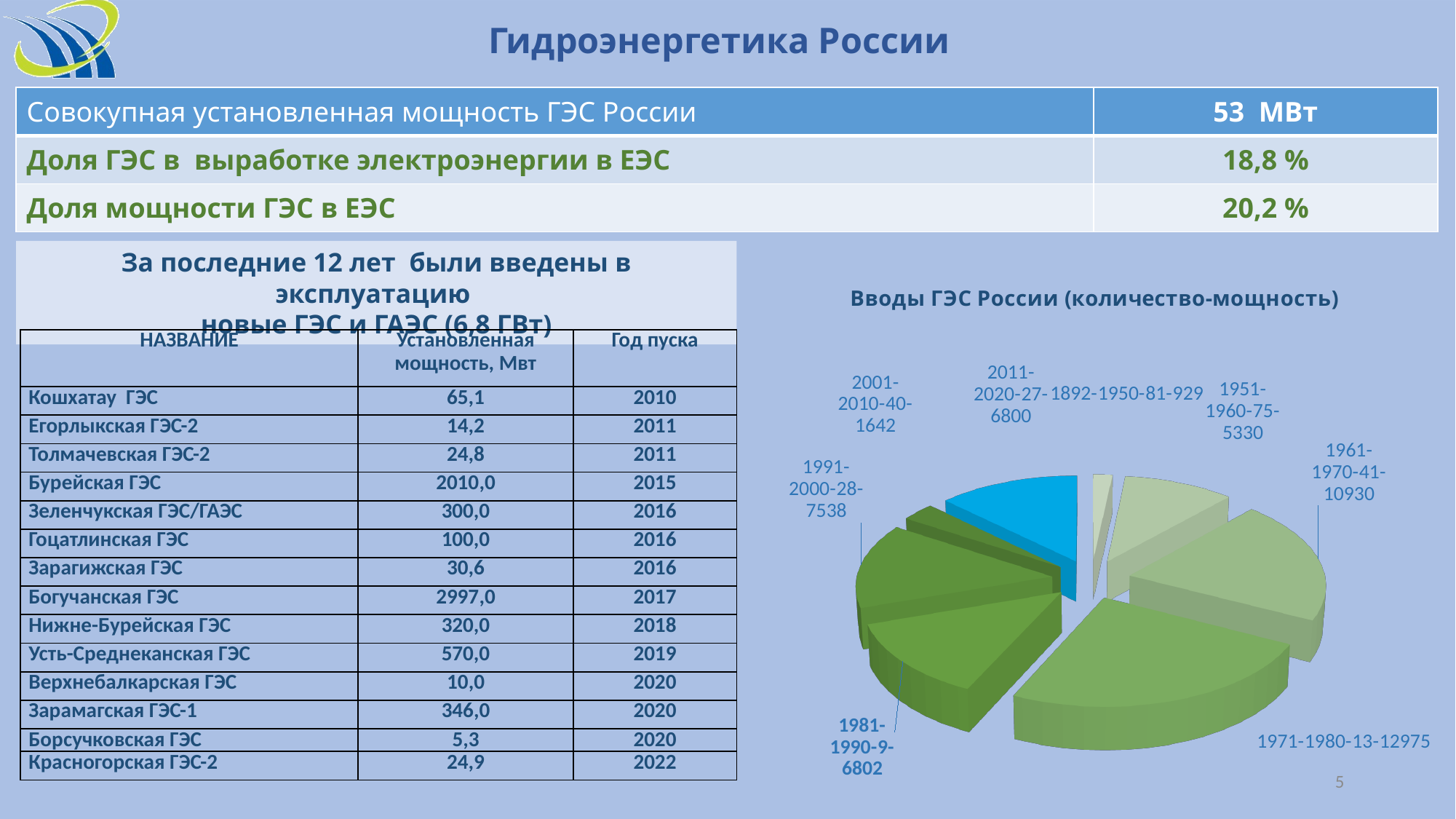
In the pie chart, what capacity value is shown in the label for the period 1892-1950? 929 What is the difference between the capacity values for 1971-1980 and 1961-1970 in the pie chart? 2045 Which period has the smallest capacity value in the pie chart? 1892-1950 In the pie chart, what capacity value is shown in the label for the period 2011-2020? 6800 Which period is represented by the blue slice in the pie chart? 2011-2020 In the pie chart, which has the larger capacity value: 1991-2000 or 1981-1990? 1991-2000 In the pie chart, what capacity value is shown in the label for the period 1971-1980? 12975 Which period has the largest capacity value in the pie chart? 1971-1980 What kind of chart is shown under the title "Вводы ГЭС России (количество-мощность)"? pie chart How many slices does the pie chart "Вводы ГЭС России (количество-мощность)" have? 8 In the pie chart, what number of plants is shown in the label for the period 1961-1970? 41 What is the title of the pie chart on the right of the slide? Вводы ГЭС России (количество-мощность)